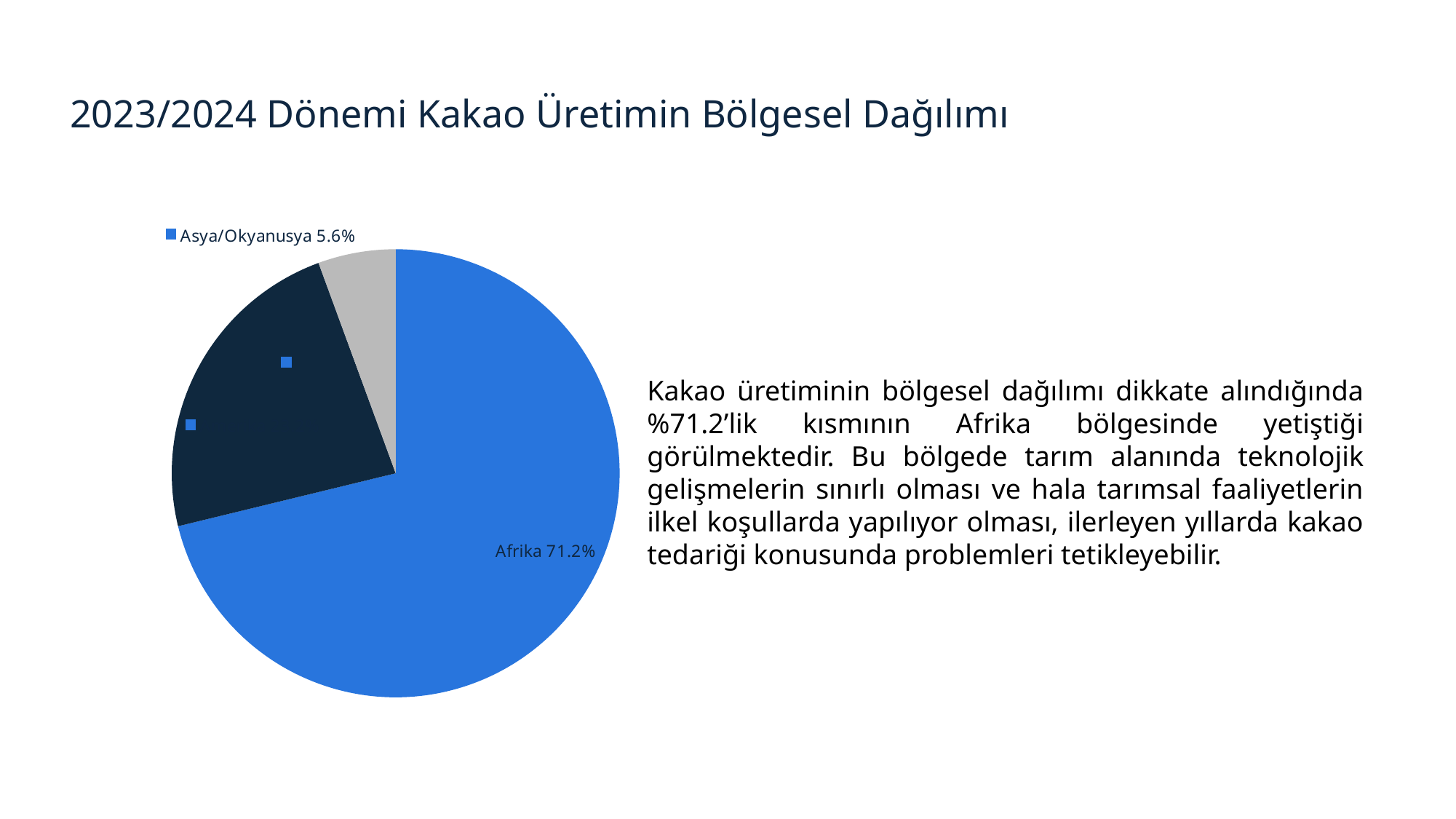
Which labelled region has the smallest slice of the pie chart? Asya/Okyanusya What percentage is shown for Asya/Okyanusya in the pie chart? 5.6% What is the title of the slide containing the chart? 2023/2024 Dönemi Kakao Üretimin Bölgesel Dağılımı What percentage of cocoa production does Afrika account for in the pie chart? 71.2% Which labelled region has the largest slice of the pie chart? Afrika How many slices does the pie chart have? 3 Which is larger, the share for Afrika or the share for Asya/Okyanusya? Afrika What share of the pie does the Afrika slice represent? 71.2% What colour is the Afrika slice in the pie chart? Blue What kind of chart is shown on the slide? Pie chart What is the difference in percentage points between Afrika and Asya/Okyanusya? 65.6